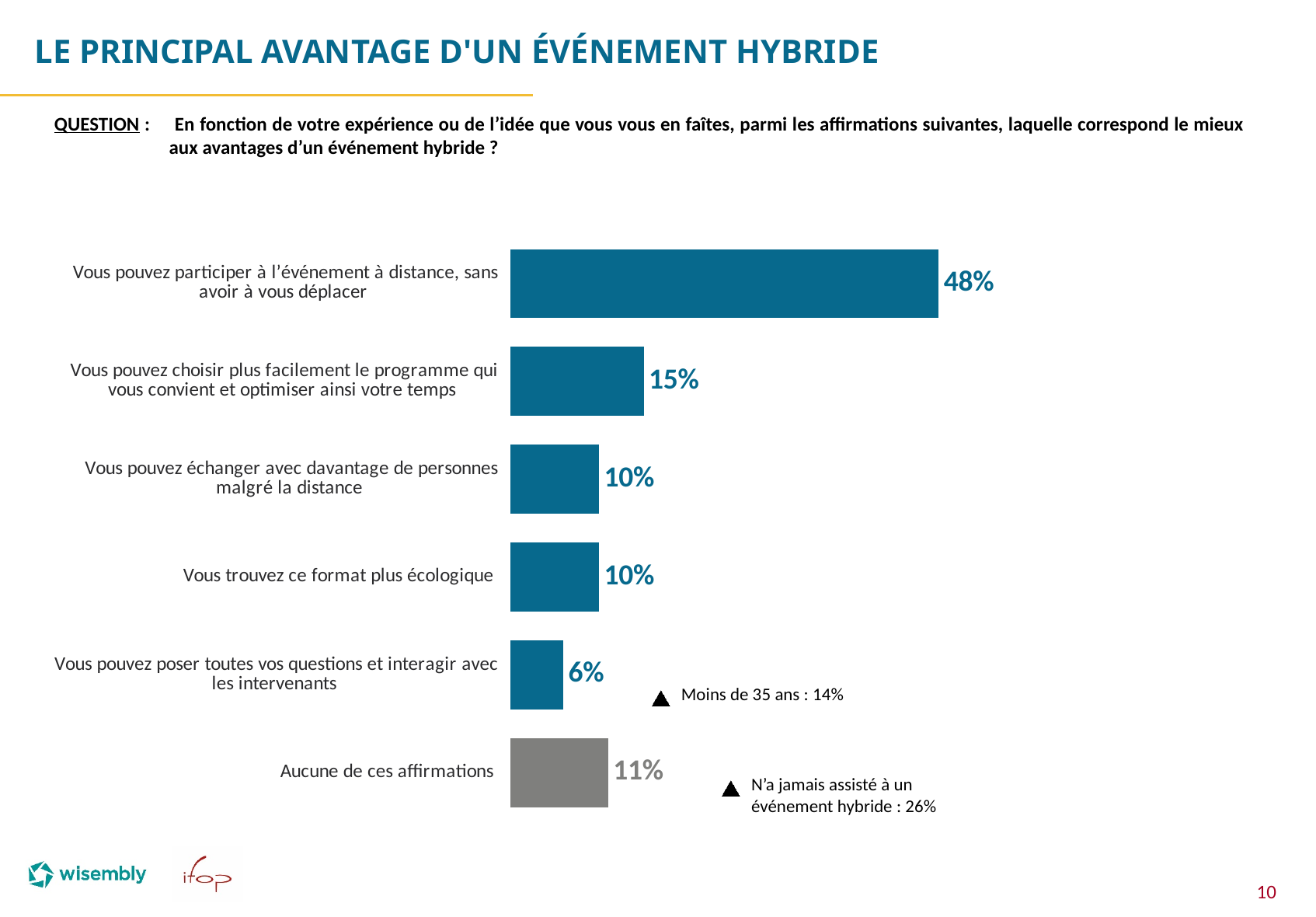
What kind of chart is shown on the slide? Bar chart How many bars are shown in the chart? 6 Which affirmation has the lowest percentage? Vous pouvez poser toutes vos questions et interagir avec les intervenants Which is larger: the value for "Aucune de ces affirmations" or the value for "Vous trouvez ce format plus écologique"? Aucune de ces affirmations What is the value for "Vous pouvez échanger avec davantage de personnes malgré la distance"? 10% What is the value for "Vous pouvez poser toutes vos questions et interagir avec les intervenants"? 6% What is the value for "Vous pouvez choisir plus facilement le programme qui vous convient et optimiser ainsi votre temps"? 15% Which affirmation has the highest percentage? Vous pouvez participer à l'événement à distance, sans avoir à vous déplacer What percentage of respondents chose "Vous pouvez participer à l'événement à distance, sans avoir à vous déplacer"? 48% What is the value for "Aucune de ces affirmations"? 11% What is the difference between the value for "Vous pouvez participer à l'événement à distance, sans avoir à vous déplacer" and the value for "Vous pouvez choisir plus facilement le programme qui vous convient et optimiser ainsi votre temps"? 33% Which bar is shown in grey rather than blue? Aucune de ces affirmations